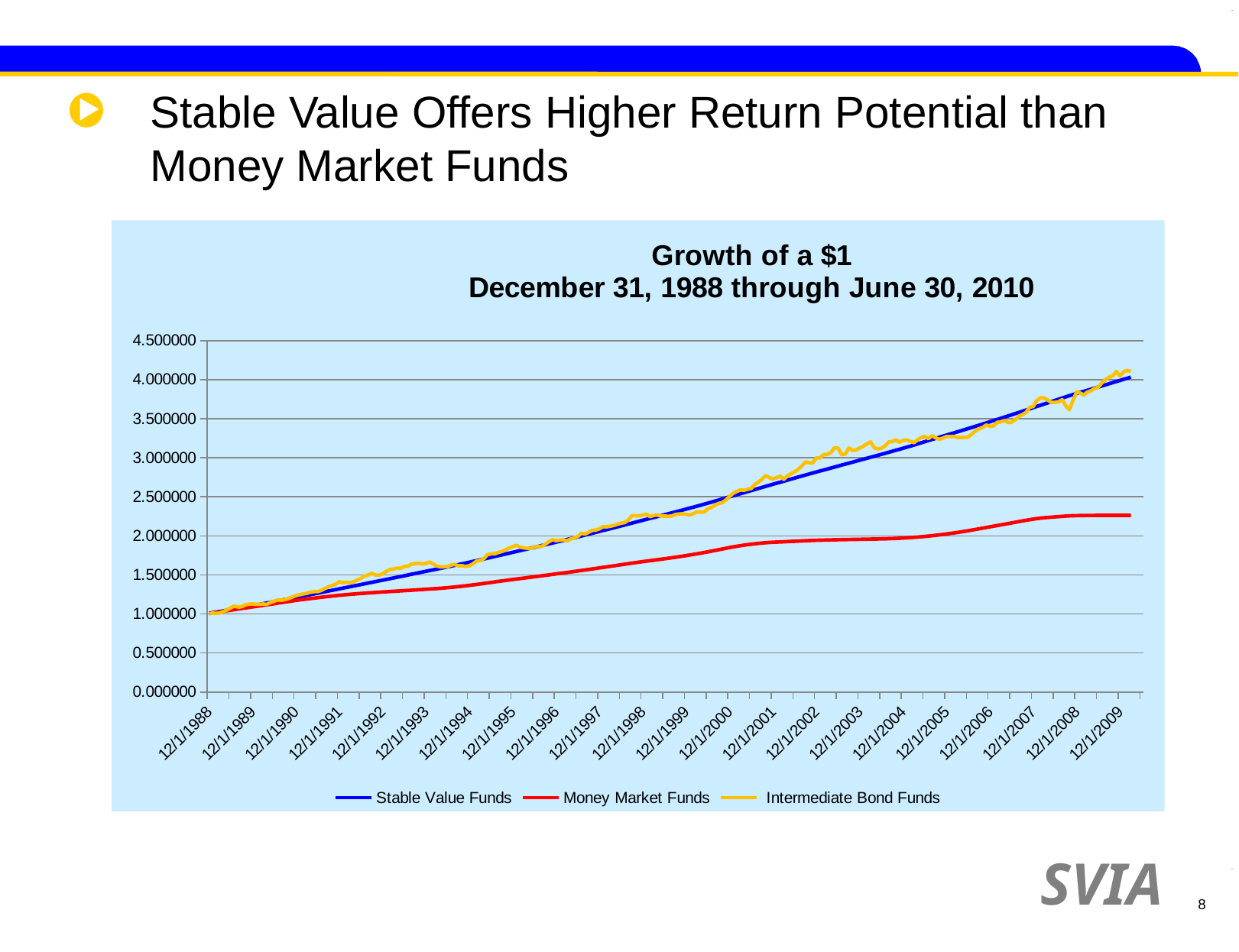
What is the title of the chart? Growth of a $1 December 31, 1988 through June 30, 2010 How many date labels are shown on the x axis? 22 At 12/1/2009, which is larger: Stable Value Funds or Money Market Funds? Stable Value Funds Is the value for Money Market Funds at 12/1/2009 greater or less than 2.000000? greater Is the value for Stable Value Funds at 12/1/2005 greater or less than 3.000000? greater Which series has the lowest value at 12/1/2009? Money Market Funds What kind of chart is shown on the slide? Line chart Does the Stable Value Funds line rise or fall across the x axis? Rise Which series is drawn in red? Money Market Funds How many series does the legend list? 3 Does the Money Market Funds line rise or fall from 12/1/1988 to 12/1/2009? Rise Is the value for Money Market Funds at 12/1/2000 greater or less than 2.000000? less